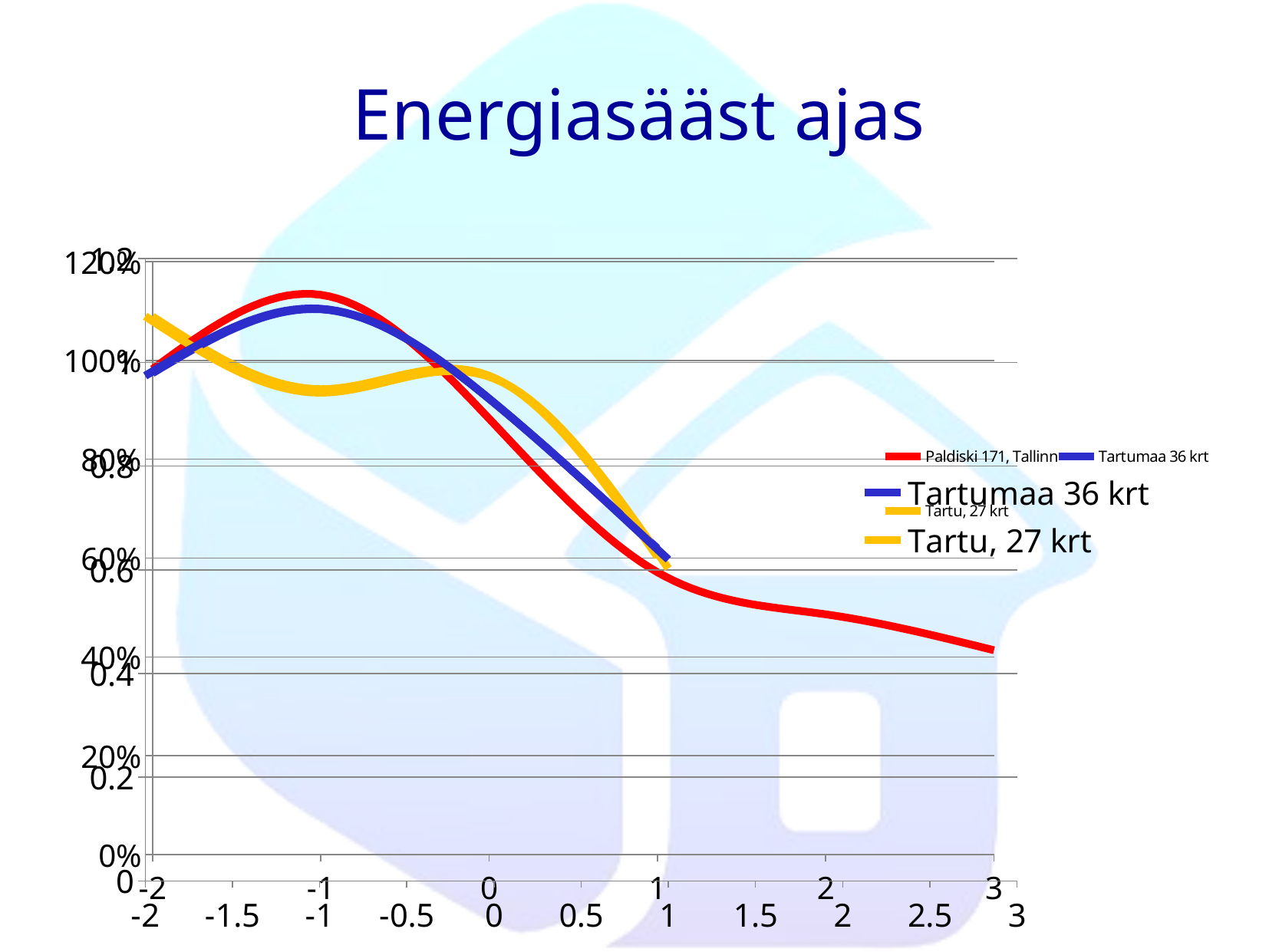
Which colour is used for the Paldiski 171, Tallinn series? red Is the value for Tartu, 27 krt at x = -2 greater or less than 100%? greater Does the Paldiski 171, Tallinn series rise or fall between x = 0 and x = 3? fall Is the value for Tartumaa 36 krt at x = 1 greater or less than 80%? less At x = -1, which series has the higher value: Paldiski 171, Tallinn or Tartu, 27 krt? Paldiski 171, Tallinn What kind of chart is shown on the slide? line chart Is the value for Tartu, 27 krt at x = -1 greater or less than 100%? less What is the title of the chart? Energiasääst ajas